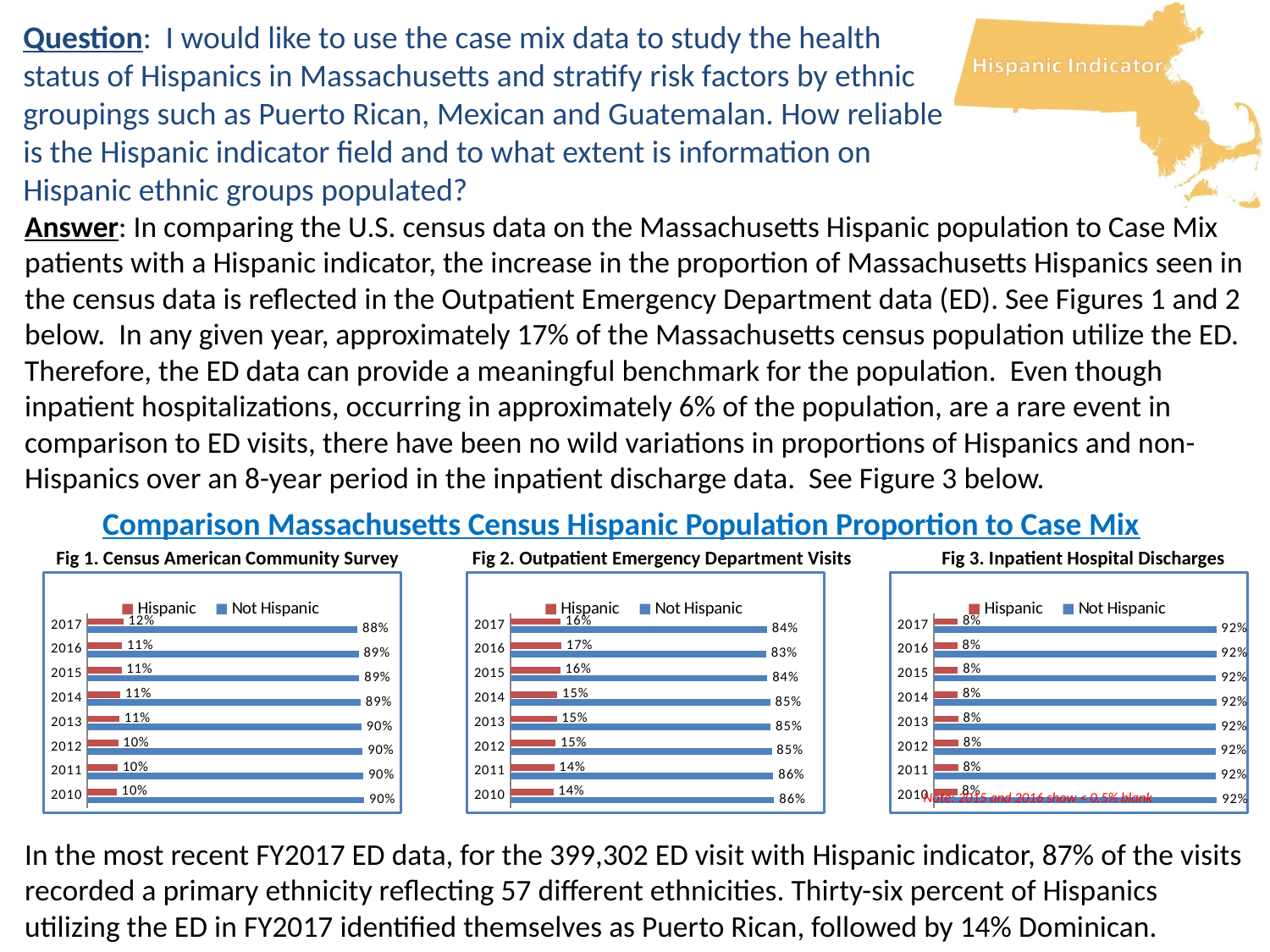
In Fig 1. Census American Community Survey, what is the Not Hispanic value for 2010? 90% How many series does the legend list in Fig 2. Outpatient Emergency Department Visits? 2 In Fig 3. Inpatient Hospital Discharges, what is the Not Hispanic value for 2014? 92% What is the title of the chart on the left of the slide? Fig 1. Census American Community Survey In Fig 1. Census American Community Survey, what is the Hispanic value for 2017? 12% In Fig 1. Census American Community Survey, is the Hispanic value for 2010 larger or smaller than the Hispanic value for 2017? Smaller What kind of chart is Fig 3. Inpatient Hospital Discharges? Bar chart In Fig 2. Outpatient Emergency Department Visits, what is the Hispanic value for 2016? 17% How many years are shown in Fig 1. Census American Community Survey? 8 In Fig 2. Outpatient Emergency Department Visits, which year has the highest Hispanic value? 2016 In Fig 3. Inpatient Hospital Discharges, what is the Hispanic value for 2011? 8% In Fig 2. Outpatient Emergency Department Visits, what is the difference between the Not Hispanic values for 2010 and 2017? 2%